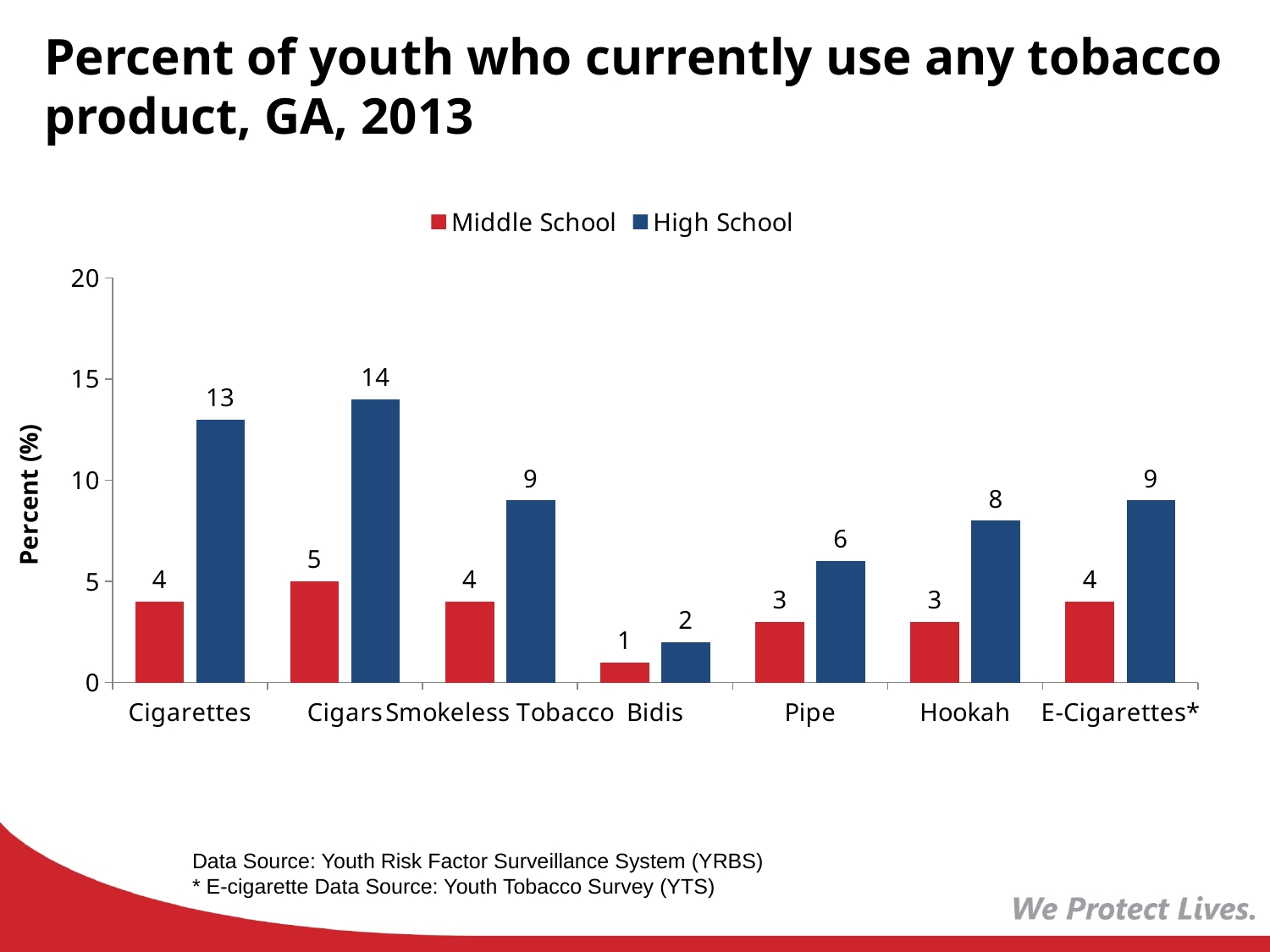
How many tobacco product categories are shown on the x axis? 7 What is the label of the y axis? Percent (%) Which category has the lowest Middle School value? Bidis Which is larger, the High School value for Pipe or the High School value for Hookah? Hookah What is the High School value for Cigars? 14 Which category has the highest High School value? Cigars What kind of chart is shown on the slide? bar chart What is the difference between the High School and Middle School values for Cigarettes? 9 Is the High School value for Smokeless Tobacco greater or less than 10? less What is the Middle School value for Bidis? 1 How many series does the legend list? 2 What is the High School value for Hookah? 8